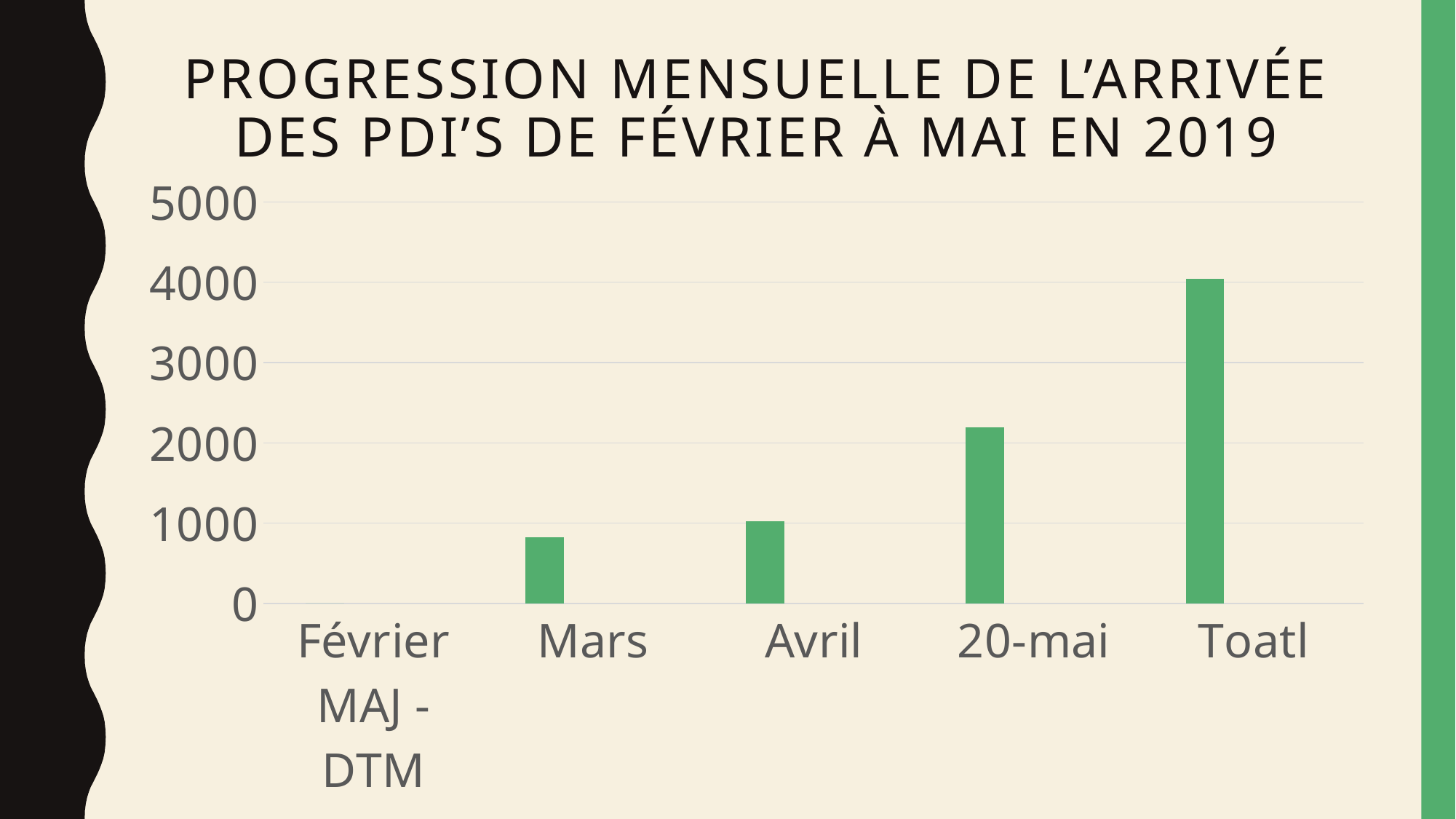
Do the bar values rise or fall from Mars to Toatl along the x axis? rise Among Mars, Avril and 20-mai, which category has the lowest bar? Mars What is the highest value shown on the vertical axis of the chart? 5000 Which category has the highest bar in the chart? Toatl How many categories are shown on the x axis of the chart? 5 Is the value for Mars greater or less than 1000? less Is the value for 20-mai greater or less than 2000? greater Is the value for Toatl greater or less than 5000? less What colour are the bars in the chart? green What kind of chart is shown on the slide? bar chart Which is larger, the value for Avril or the value for 20-mai? 20-mai